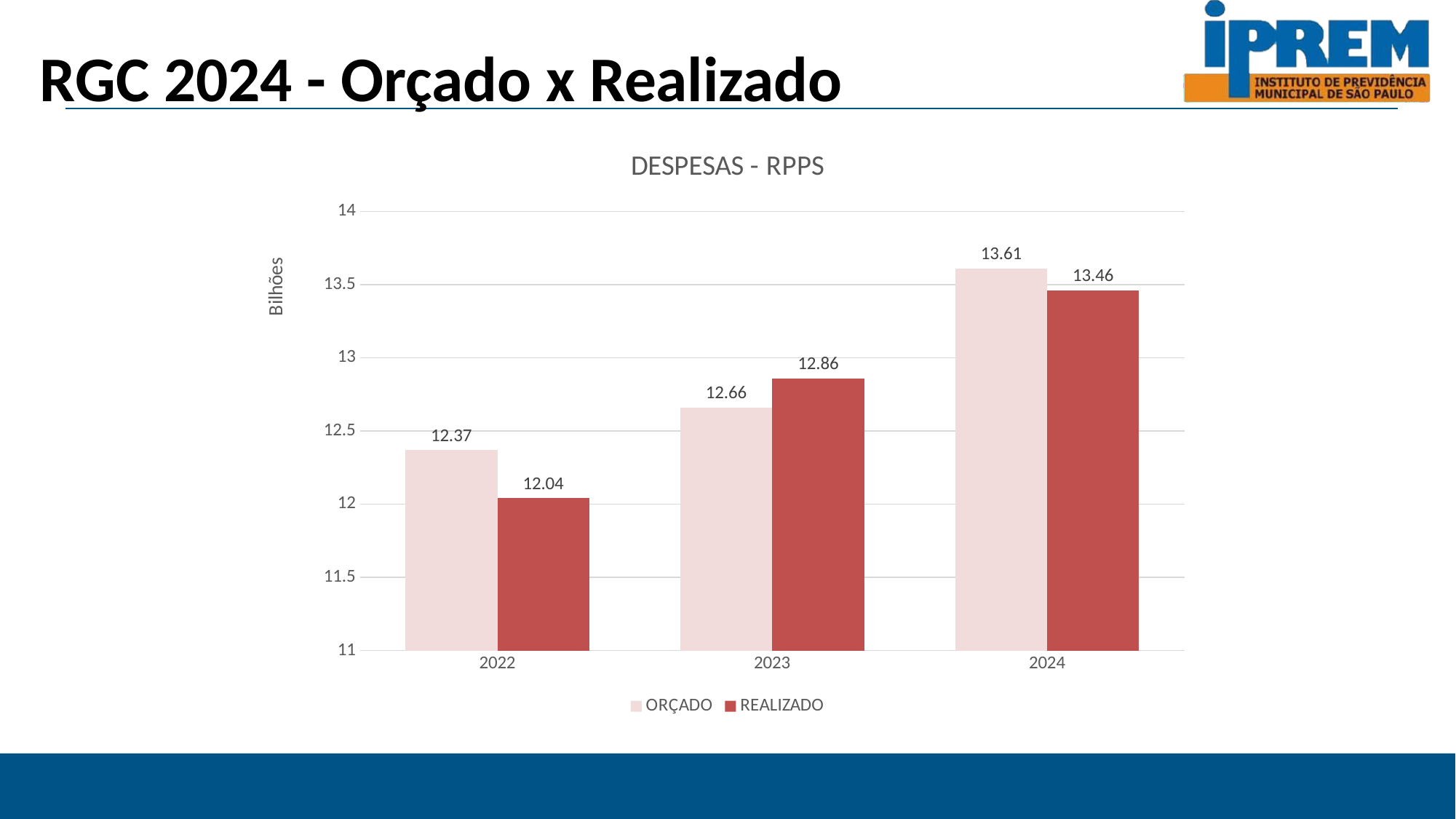
What is the REALIZADO value for 2024? 13.46 Is the REALIZADO value for 2024 greater or less than 13? greater What is the ORÇADO value for 2022? 12.37 Which year has the lowest REALIZADO value? 2022 What is the difference between ORÇADO and REALIZADO in 2022? 0.33 What kind of chart is shown? bar chart How many series does the legend list? 2 Do the REALIZADO values rise or fall from 2022 to 2024? rise How many years are shown on the x axis? 3 Which year has the highest ORÇADO value? 2024 In 2023, which is larger, ORÇADO or REALIZADO? REALIZADO What is the REALIZADO value for 2023? 12.86